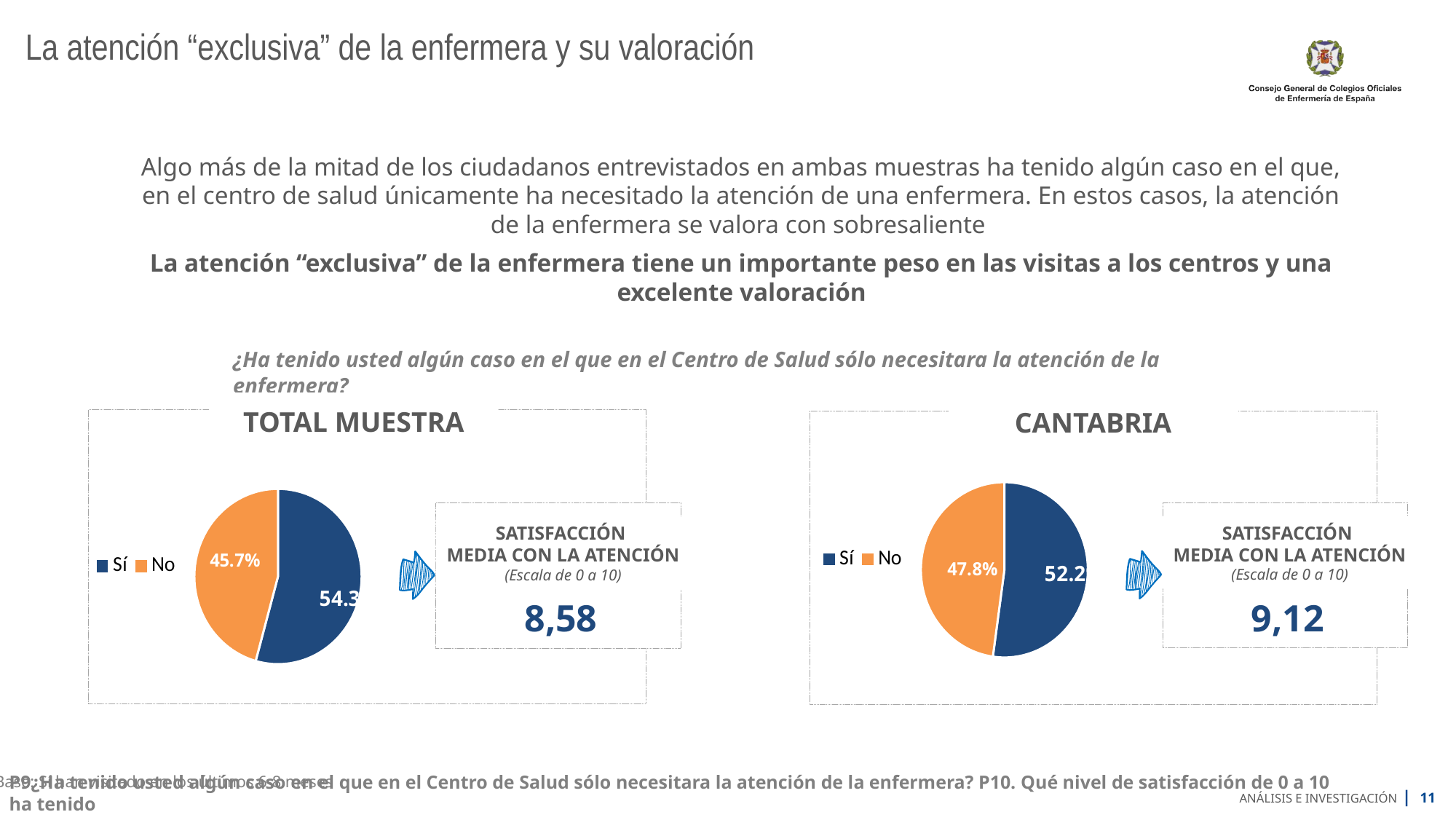
In the CANTABRIA pie chart, which slice is larger, Sí or No? Sí In the TOTAL MUESTRA pie chart, which slice is larger, Sí or No? Sí In the CANTABRIA pie chart, which category has the largest share? Sí What kind of chart is used under the TOTAL MUESTRA heading? Pie chart In the TOTAL MUESTRA pie chart, what percentage of respondents answered No? 45.7% In the TOTAL MUESTRA pie chart, what colour is the Sí slice? Dark blue How many entries does the legend of the TOTAL MUESTRA pie chart list? 2 How many categories does the CANTABRIA pie chart show? 2 In the TOTAL MUESTRA pie chart, which category has the smallest share? No In the CANTABRIA pie chart, what colour is the No slice? Orange In the CANTABRIA pie chart, what percentage of respondents answered No? 47.8% Is the No share in the CANTABRIA pie chart greater or less than 50%? less